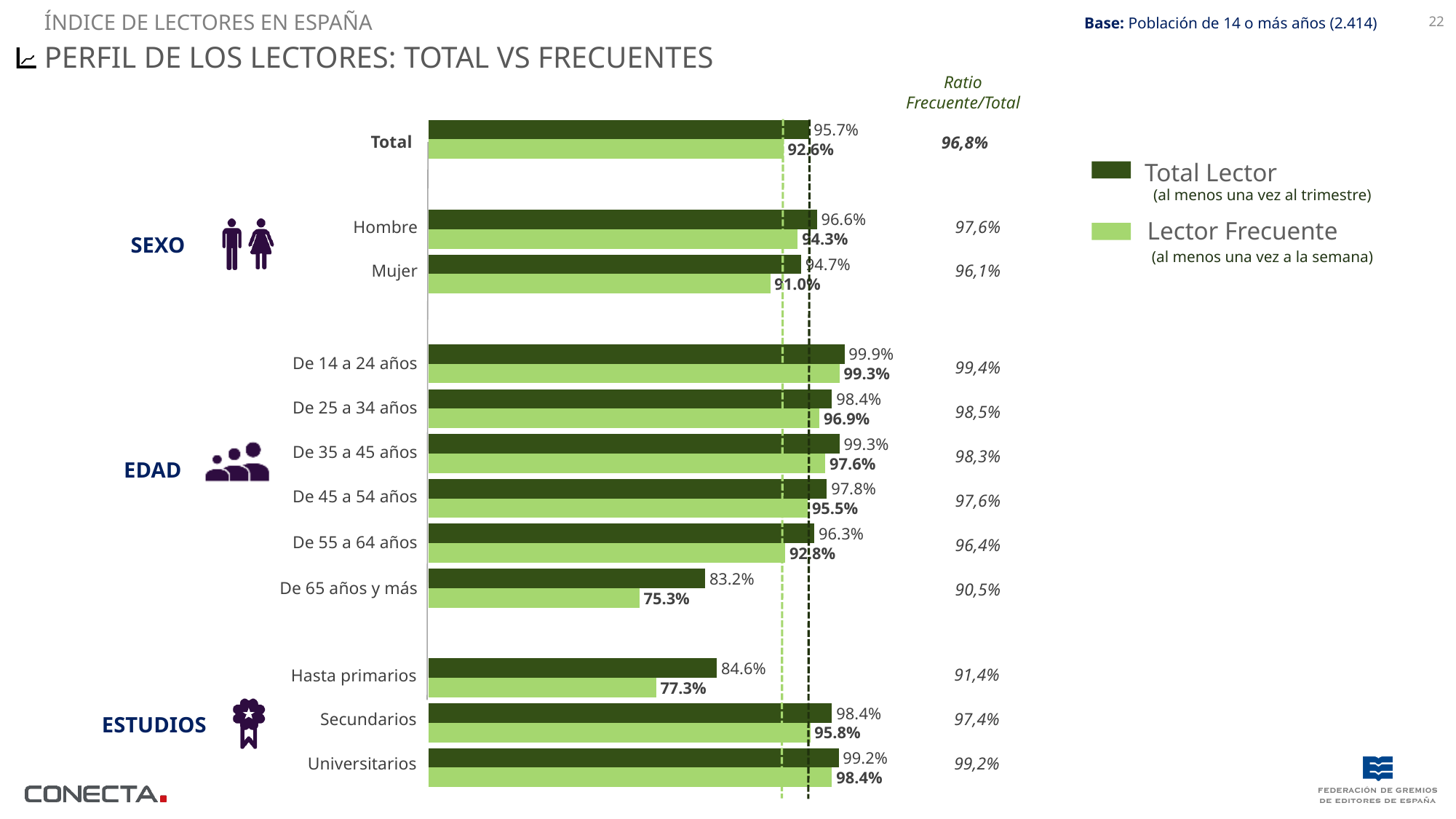
How many categories are plotted in the chart, including Total? 12 What is the Total Lector value for Mujer? 94.7% What is the Ratio Frecuente/Total shown for De 65 años y más? 90,5% Which is larger, the Lector Frecuente value for Hombre or for Mujer? Hombre How many series does the legend list? 2 Which category has the lowest Lector Frecuente value? De 65 años y más What is the difference between the Total Lector and Lector Frecuente values for Hasta primarios? 7.3% What is the Lector Frecuente value for Universitarios? 98.4% What is the Total Lector value for Hombre? 96.6% Which category has the highest Total Lector value? De 14 a 24 años What is the Lector Frecuente value for De 65 años y más? 75.3% What kind of chart is shown on the slide? Bar chart